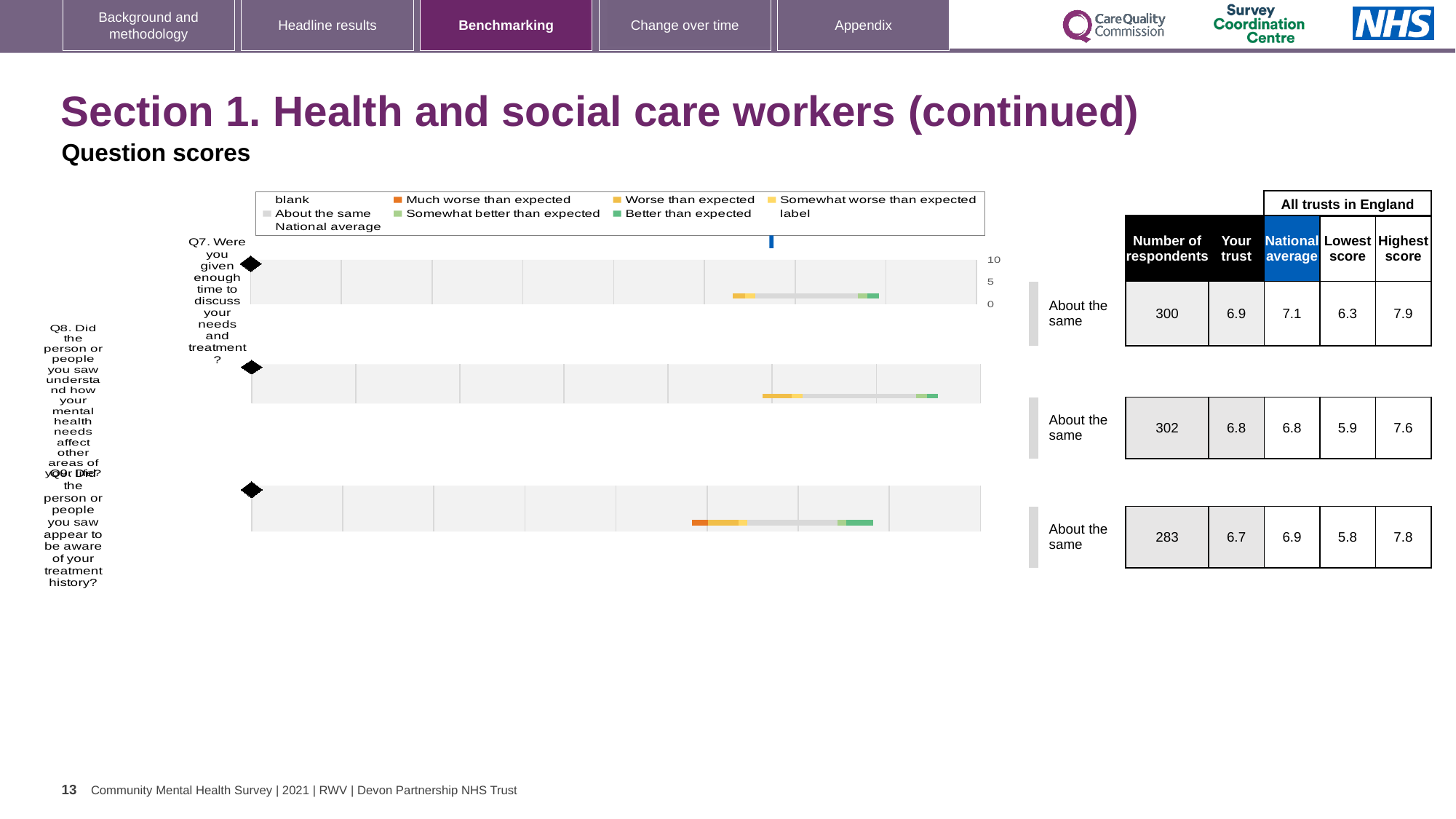
For the Q9 chart, is the 'Your trust' score higher or lower than the national average? lower Which of the three questions (Q7, Q8, Q9) has the fewest respondents? Q9 What benchmark category is shown next to each of the three charts? About the same For the Q7 chart (time to discuss needs and treatment), what is the 'Your trust' score shown in the table? 6.9 What kind of chart is used to show the question scores for Q7, Q8 and Q9? bar chart What is the maximum value shown on the score axis of the charts? 10 For the Q9 chart (awareness of treatment history), what is the lowest score among all trusts in England? 5.8 For the Q9 chart, what is the highest score among all trusts in England? 7.8 For the Q7 chart, what is the national average score? 7.1 For the Q7 chart, what is the difference between the highest score and the lowest score across all trusts in England? 1.6 How many questions (Q7, Q8, Q9) are plotted as separate charts on the slide? 3 For the Q8 chart (understanding how mental health needs affect other areas of life), how many respondents are listed? 302